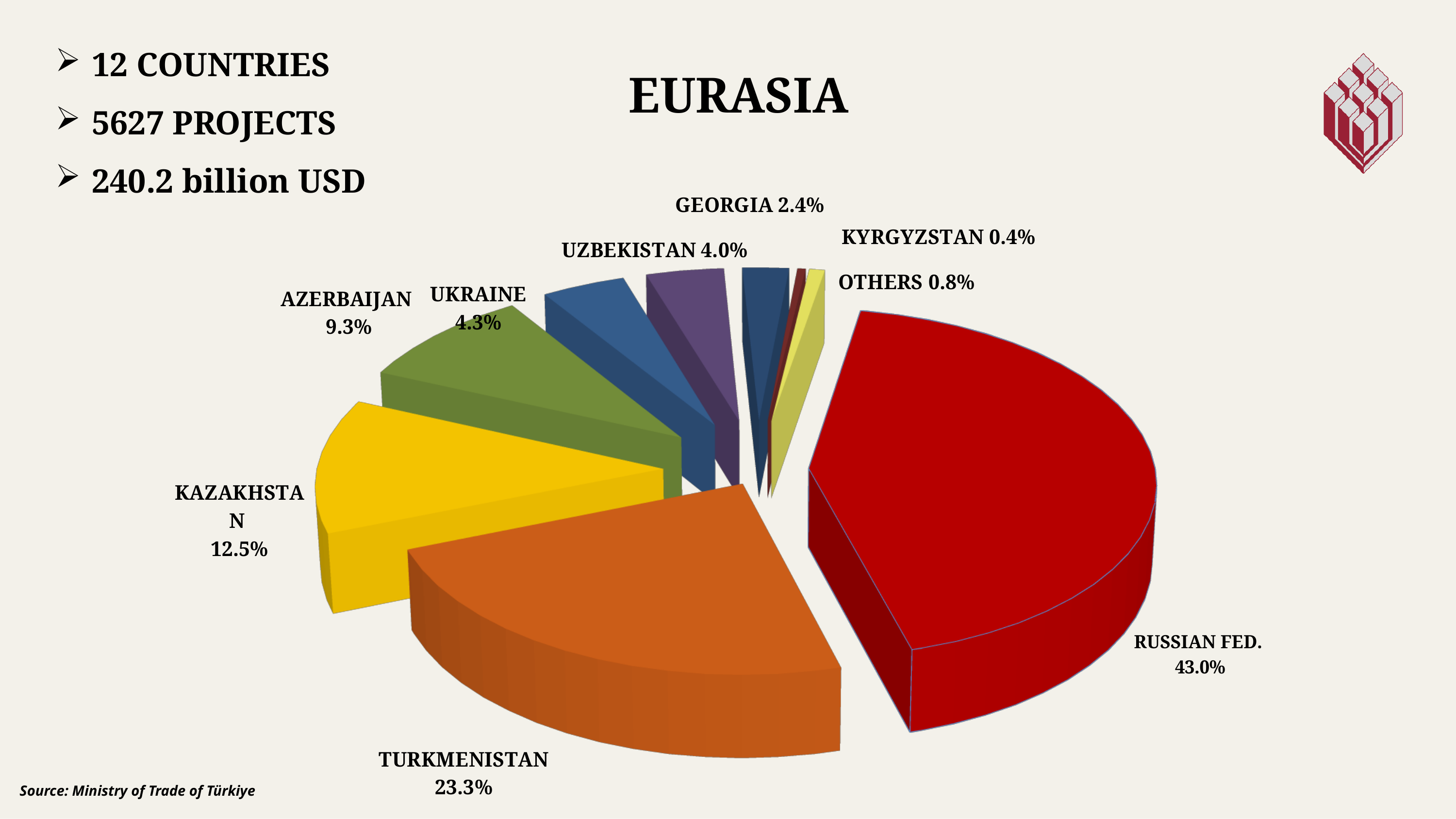
What type of chart is shown on the slide? Pie chart What is the difference between the shares of the Russian Fed. and Turkmenistan? 19.7% What is the title of the chart? EURASIA What share of the pie does the Russian Fed. hold? 43.0% How many slices does the pie chart have? 9 What is the value shown for Kazakhstan? 12.5% Which has a larger share, Ukraine or Uzbekistan? Ukraine What is the value shown for Turkmenistan? 23.3% What is the value shown for Kyrgyzstan? 0.4% Which slice of the pie is the smallest? Kyrgyzstan Which slice of the pie is the largest? Russian Fed. What is the value shown for Azerbaijan? 9.3%